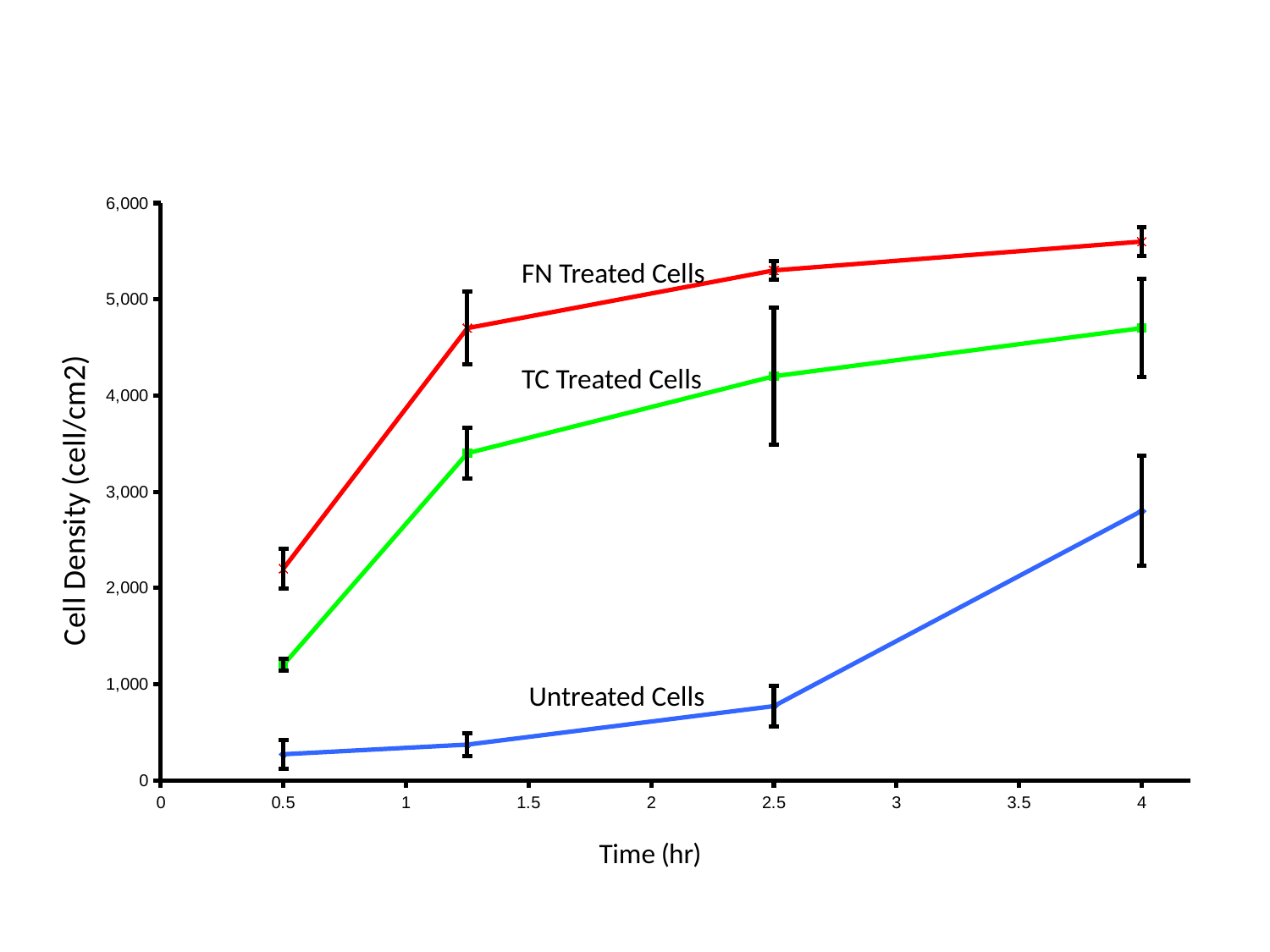
Is the cell density for Untreated Cells at 2.5 hr greater or less than 1,000? less Which series has the lowest cell density at 0.5 hr? Untreated Cells Is the cell density for TC Treated Cells at 0.5 hr greater or less than 2,000? less How many time points are plotted for each series? 4 How many series are plotted on the chart? 3 Which series has the highest cell density at 4 hr? FN Treated Cells Does the cell density of Untreated Cells rise or fall as time increases? rise At 4 hr, which is larger: the cell density of FN Treated Cells or TC Treated Cells? FN Treated Cells Is the cell density for FN Treated Cells at 4 hr greater or less than 5,000? greater What kind of chart is shown on the slide? Line chart What is the label of the y axis? Cell Density (cell/cm2)